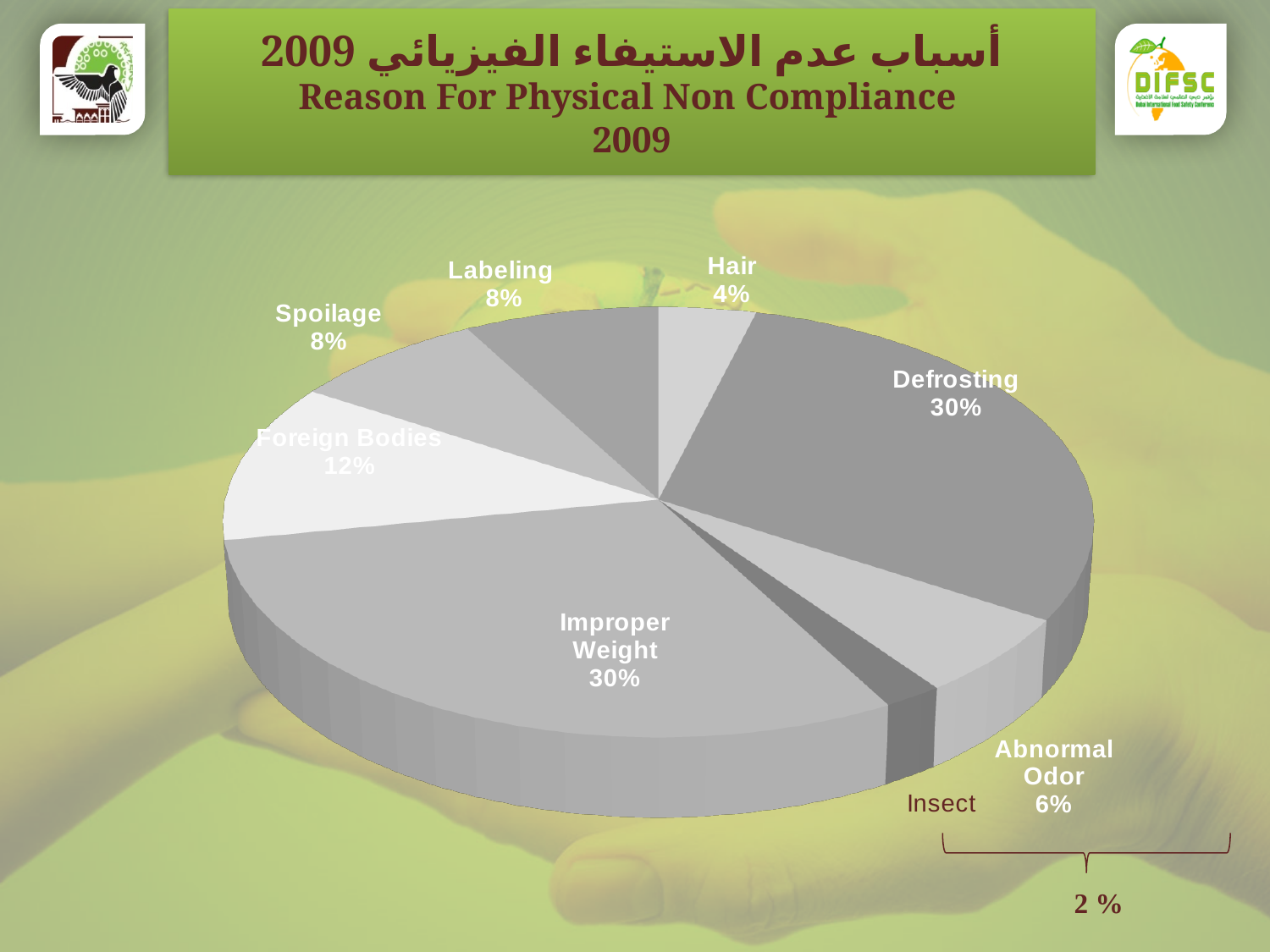
What percentage is shown for Improper Weight? 30% Which has a larger share, Foreign Bodies or Spoilage? Foreign Bodies What percentage is shown for Spoilage? 8% What percentage of physical non compliance is attributed to Defrosting? 30% What is the English title of the chart on the slide? Reason For Physical Non Compliance 2009 What percentage is shown for Abnormal Odor? 6% How many categories (slices) are labeled in the pie chart? 8 By how many percentage points does Defrosting exceed Hair? 26 percentage points What is the combined share of Spoilage and Labeling? 16% What share does Hair account for in the pie chart? 4% What kind of chart is shown on the slide? pie chart What is the percentage shown for Foreign Bodies? 12%